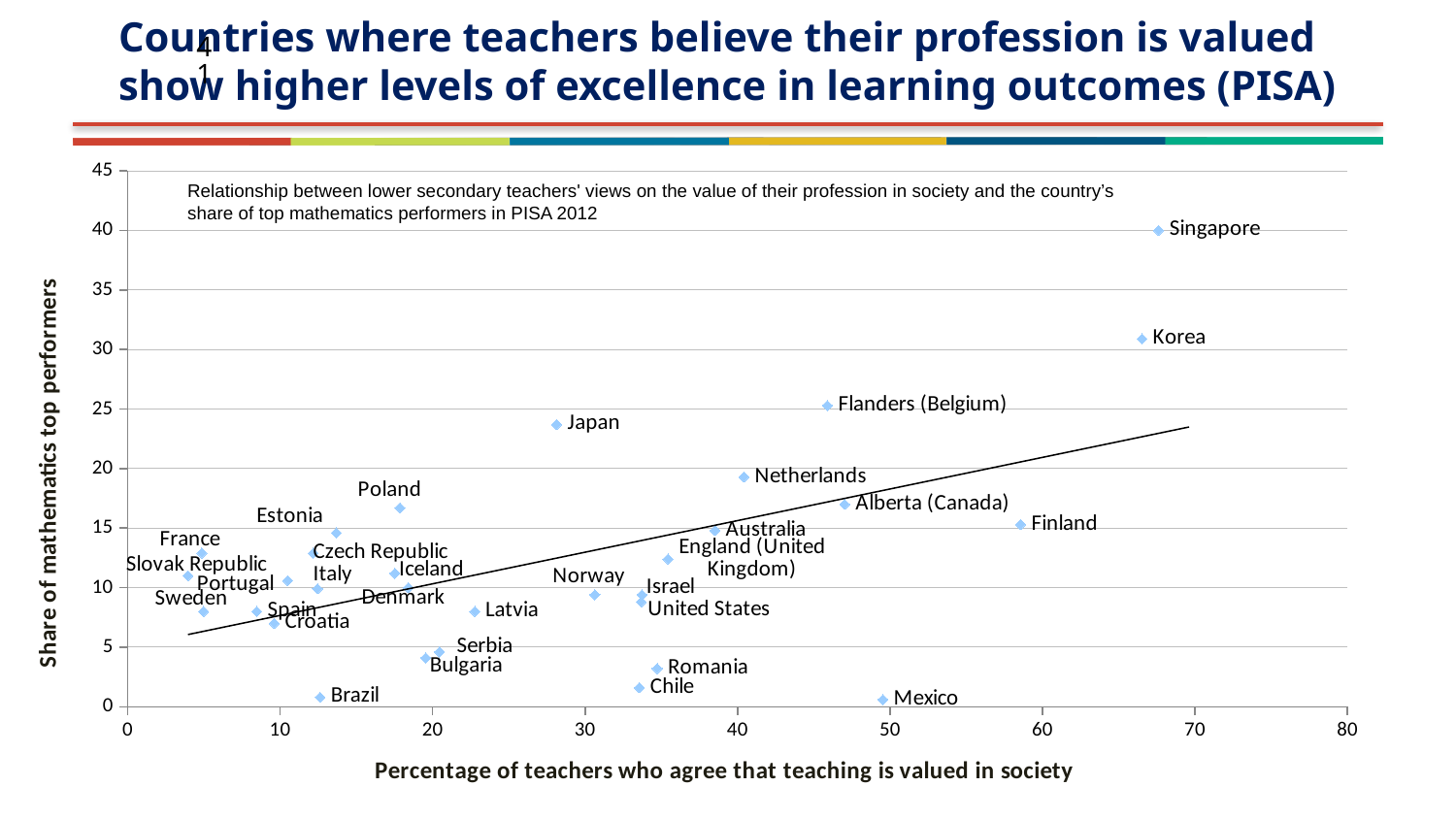
What is the label of the horizontal axis? Percentage of teachers who agree that teaching is valued in society Is the percentage of teachers who agree that teaching is valued in society for Mexico greater or less than 40? greater What is the label of the vertical axis? Share of mathematics top performers Which country has the highest share of mathematics top performers? Singapore Is the share of mathematics top performers for Japan greater or less than 20? greater What kind of chart is shown on the slide? Scatter chart Does the fitted trend line rise or fall as the percentage of teachers who agree that teaching is valued increases? rise Is the share of mathematics top performers for Brazil greater or less than 5? less Which has a higher percentage of teachers who agree that teaching is valued in society, Finland or Flanders (Belgium)? Finland Which has a higher share of mathematics top performers, Netherlands or Finland? Netherlands Which has a higher share of mathematics top performers, Korea or Japan? Korea